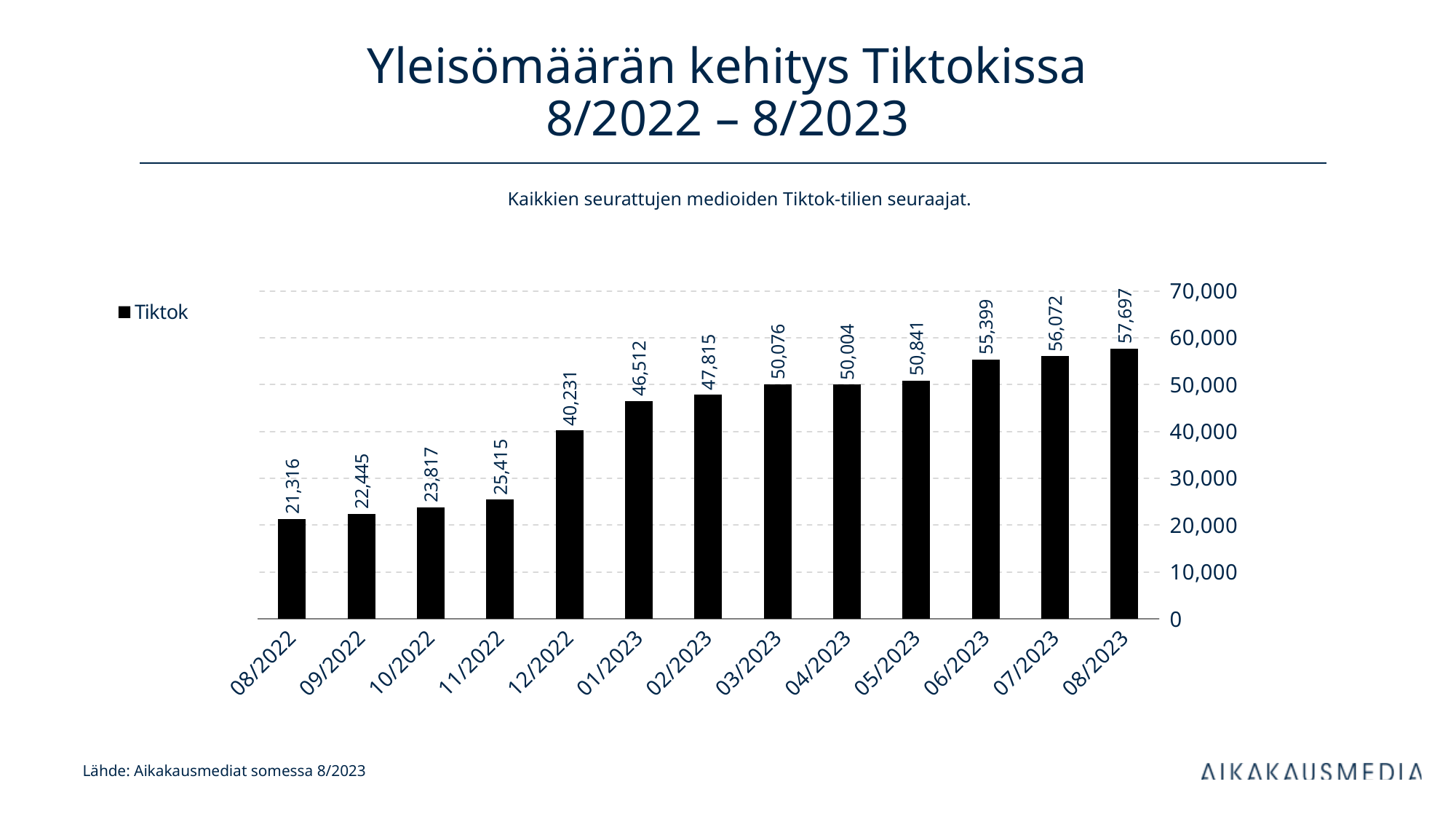
What is the difference between the values for 12/2022 and 11/2022? 14,816 Which month has the lowest value? 08/2022 Which is larger, the value for 06/2023 or the value for 01/2023? 06/2023 Which month has the highest value? 08/2023 How many series does the legend list? 1 What is the value for 08/2022? 21,316 How many months are shown on the x axis? 13 What is the difference between the values for 08/2023 and 08/2022? 36,381 Is the value for 11/2022 greater or less than 30,000? less What is the value for 12/2022? 40,231 What kind of chart is shown on the slide? bar chart What is the value for 05/2023? 50,841